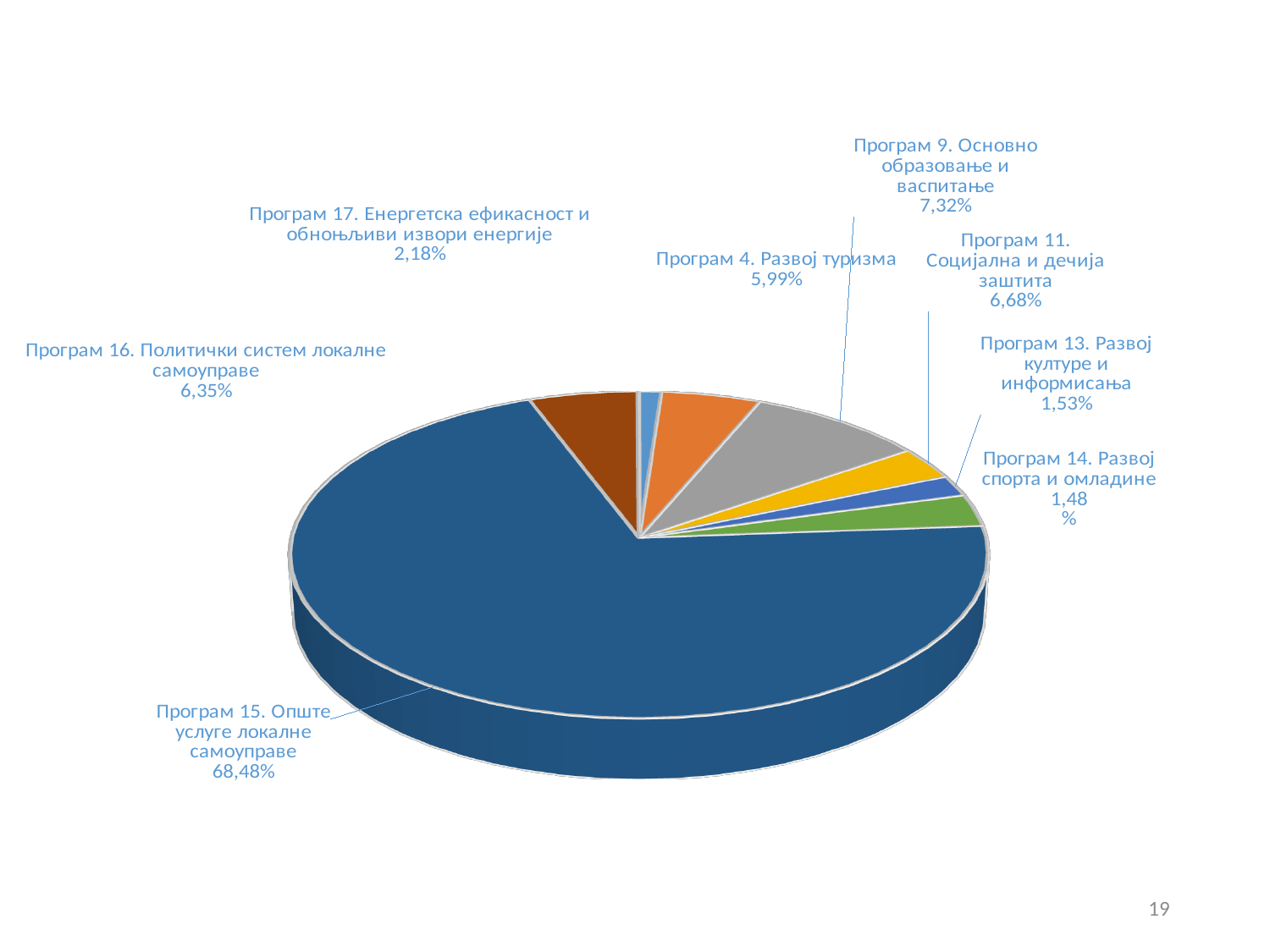
What is the difference between the shares of Програм 15. Опште услуге локалне самоуправе and Програм 9. Основно образовање и васпитање? 61,16% Which is larger, the share for Програм 9. Основно образовање и васпитање or for Програм 11. Социјална и дечија заштита? Програм 9. Основно образовање и васпитање What is the difference between the shares of Програм 9. Основно образовање и васпитање and Програм 11. Социјална и дечија заштита? 0,64% Which program has the largest slice of the pie? Програм 15. Опште услуге локалне самоуправе What is the value shown for Програм 4. Развој туризма? 5,99% What is the value shown for Програм 9. Основно образовање и васпитање? 7,32% What kind of chart is shown on the slide? Pie chart What is the value shown for Програм 16. Политички систем локалне самоуправе? 6,35% Which program has the smallest slice of the pie? Програм 14. Развој спорта и омладине What share of the pie does Програм 15. Опште услуге локалне самоуправе have? 68,48% What is the value shown for Програм 17. Енергетска ефикасност и обновљиви извори енергије? 2,18% How many slices does the pie chart have? 8